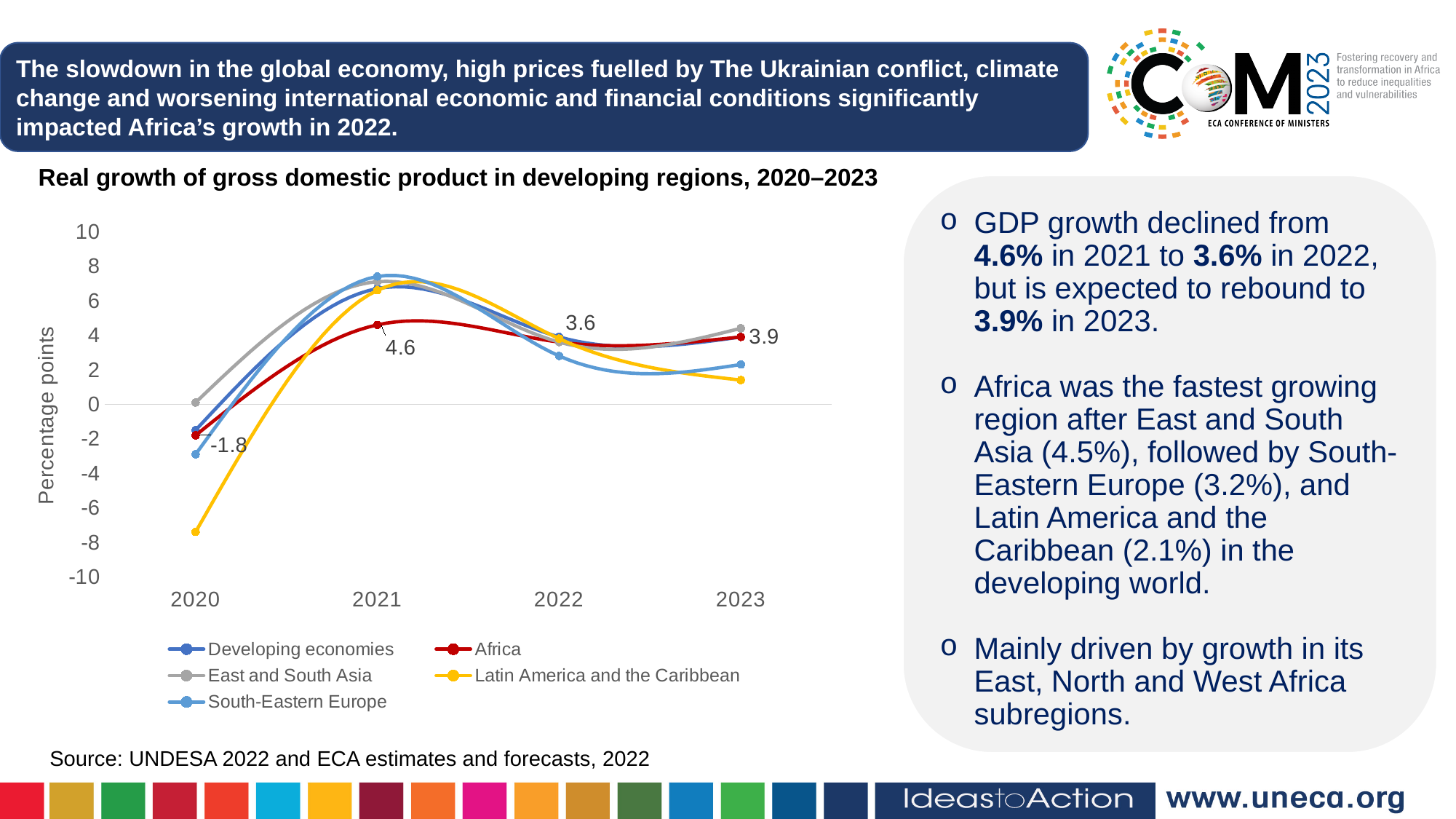
In which year is the Africa series at its highest? 2021 Which is larger in 2020, the value for Africa or the value for Latin America and the Caribbean? Africa What is the value for Africa in 2023? 3.9 What kind of chart is shown on the slide? line chart Is the value for Latin America and the Caribbean in 2020 greater or less than -6? less By how much did the Africa value fall from 2021 to 2022? 1.0 In which year is the Africa series at its lowest? 2020 What is the label on the y axis of the chart? Percentage points What is the value for Africa in 2020? -1.8 How many series does the chart legend list? 5 How many years are plotted along the x axis of the chart? 4 What is the value for Africa in 2021? 4.6